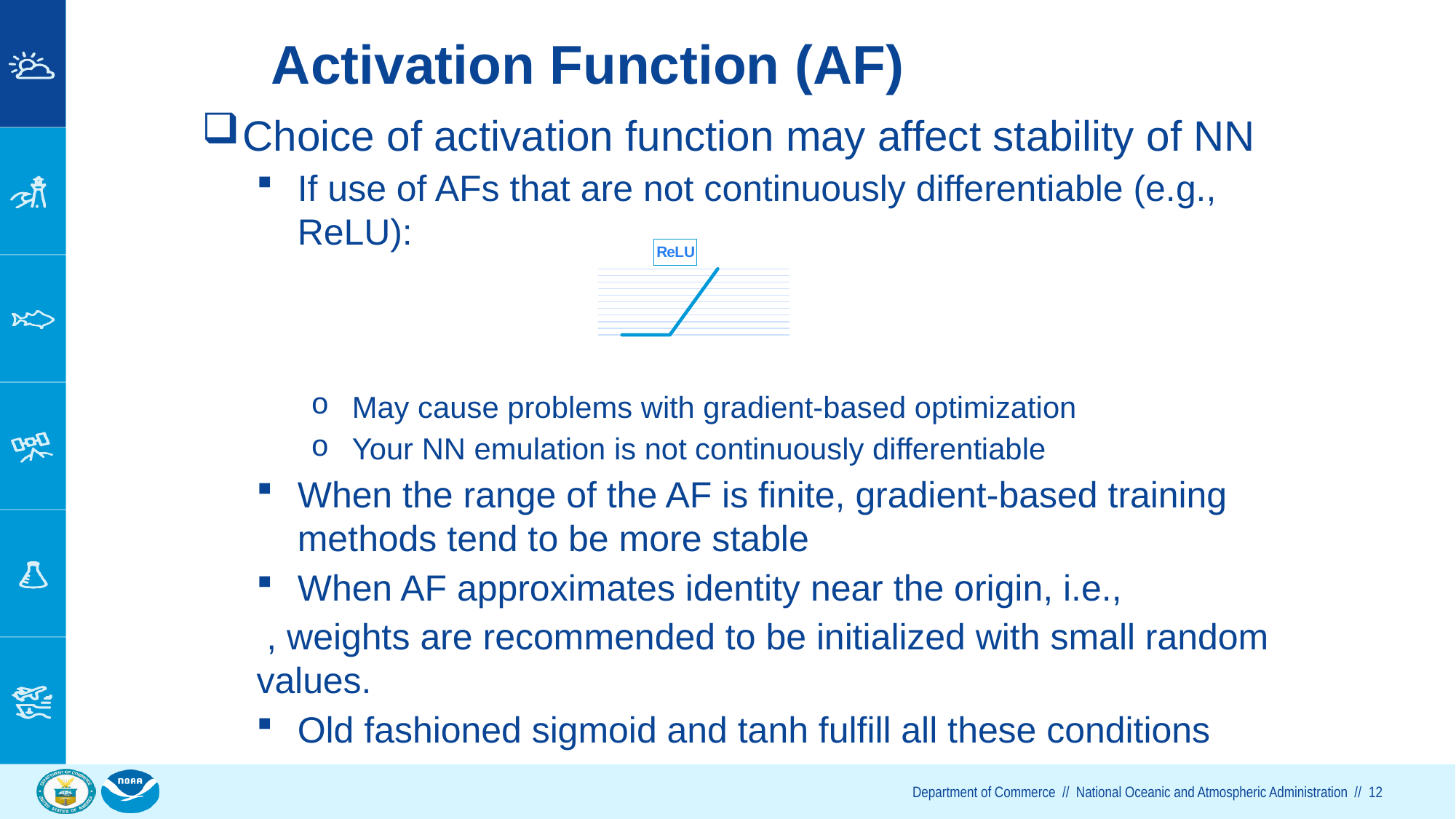
Does the plotted line rise or fall toward the right side of the chart? rise What kind of chart is shown on the slide? line chart What label is shown in the box above the chart? ReLU How many lines (series) are plotted on the chart? 1 Is the plotted line flat or rising on the left half of the chart? flat